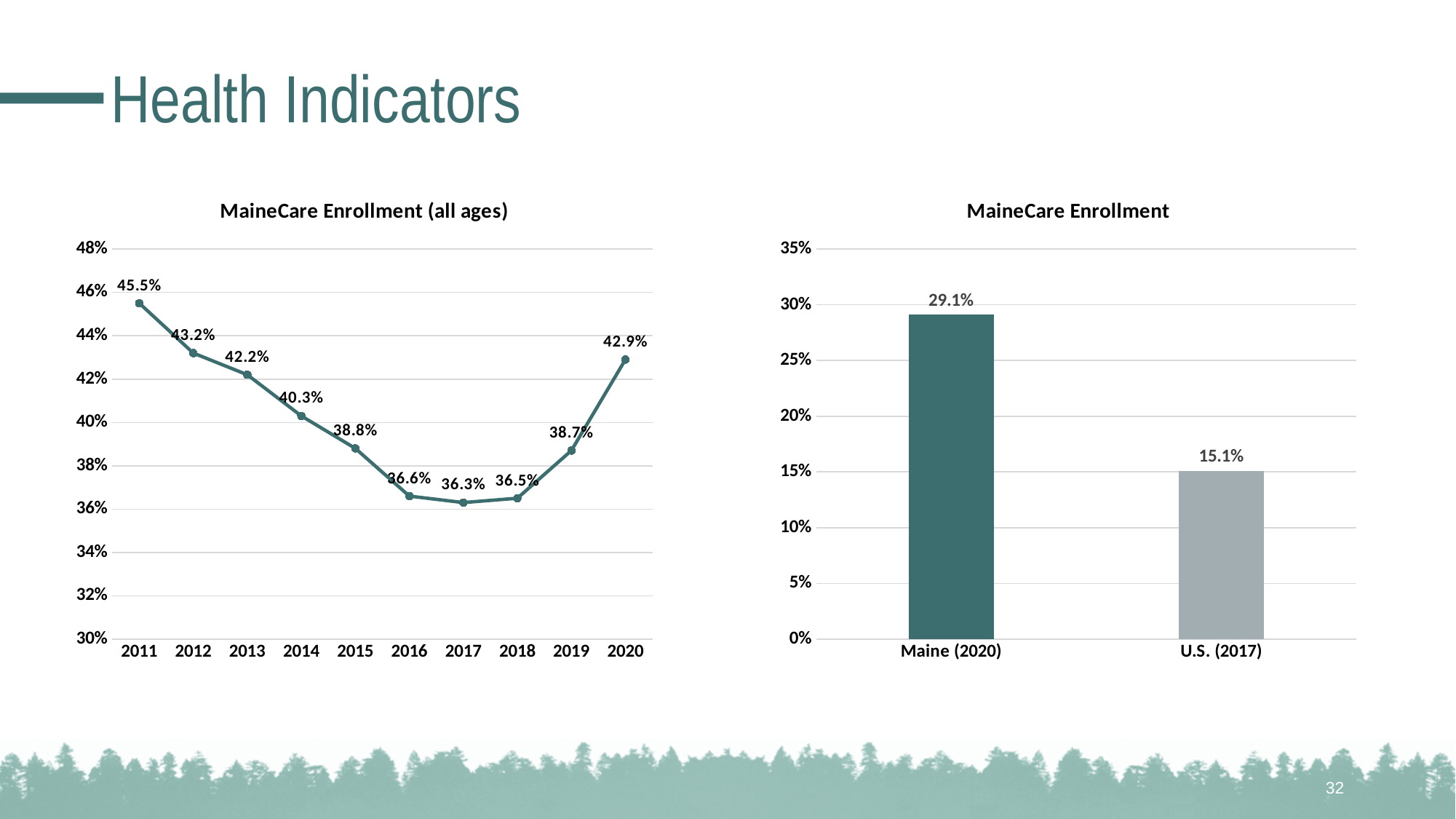
In the 'MaineCare Enrollment (all ages)' chart, what is the value for 2017? 36.3% In the 'MaineCare Enrollment (all ages)' chart, which year has the highest value? 2011 In the 'MaineCare Enrollment (all ages)' chart, what is the difference between the 2020 value and the 2019 value? 4.2% In the 'MaineCare Enrollment' chart on the right, what is the value for U.S. (2017)? 15.1% What kind of chart is the 'MaineCare Enrollment (all ages)' chart on the left? Line chart In the 'MaineCare Enrollment' chart on the right, what is the value for Maine (2020)? 29.1% In the 'MaineCare Enrollment (all ages)' chart, how many years are plotted on the x axis? 10 In the 'MaineCare Enrollment (all ages)' chart, do the values rise or fall from 2011 to 2017? Fall In the 'MaineCare Enrollment (all ages)' chart, which year has the lowest value? 2017 What kind of chart is the 'MaineCare Enrollment' chart on the right? Bar chart In the 'MaineCare Enrollment (all ages)' chart, what is the value for 2011? 45.5% In the 'MaineCare Enrollment' chart on the right, what is the difference between the Maine (2020) value and the U.S. (2017) value? 14.0%